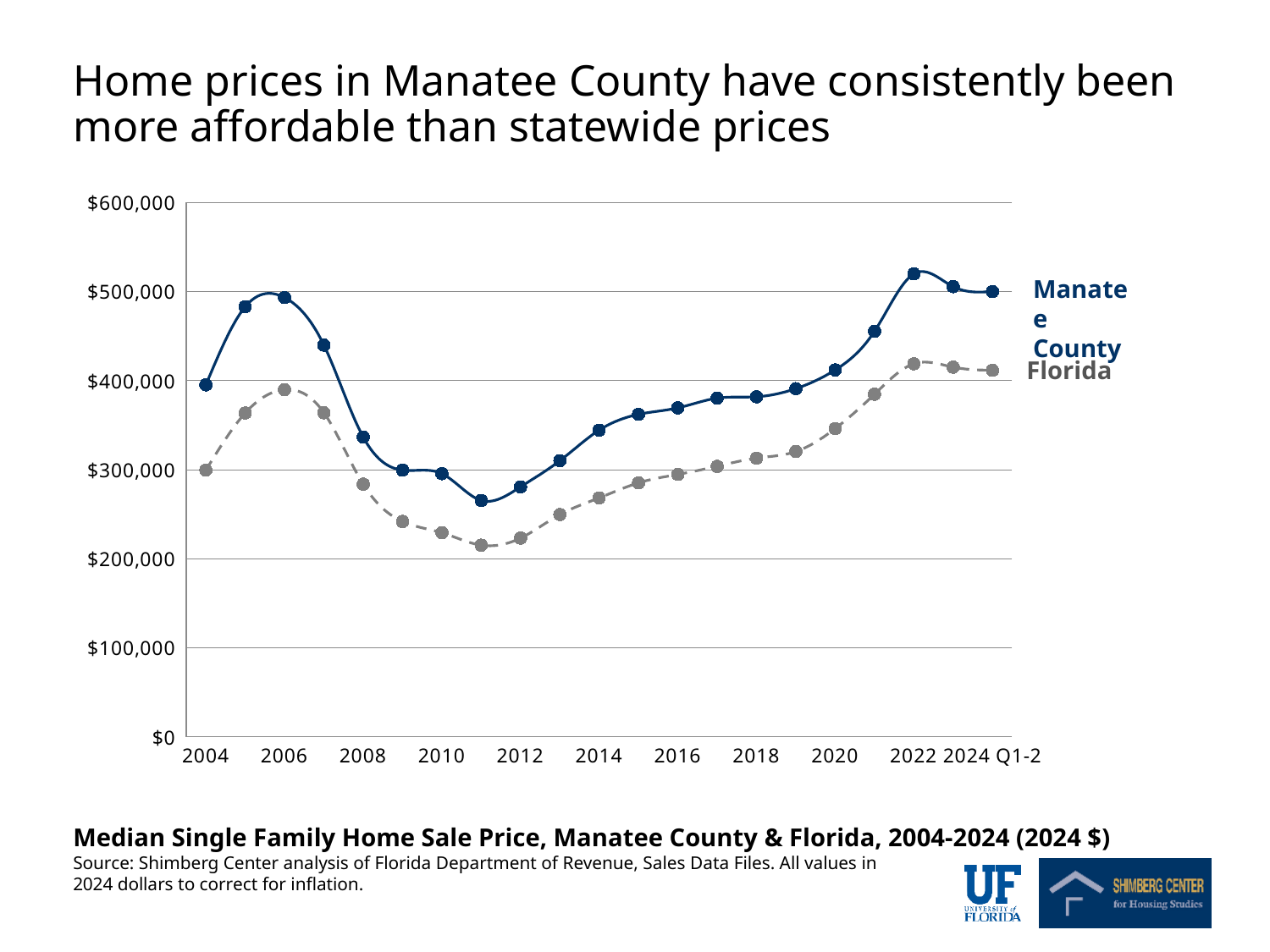
In which year does the Manatee County series reach its highest value? 2022 Is the Manatee County value for 2022 greater or less than $500,000? greater Does the Manatee County series rise or fall between 2011 and 2022? rise How many series does the chart show? 2 What kind of chart is shown on the slide? line chart In 2016, which series has the higher value, Manatee County or Florida? Manatee County Which two series are plotted on the chart? Manatee County and Florida In which year does the Florida series reach its lowest value? 2011 Is the Manatee County value for 2011 greater or less than $300,000? less Is the Florida value for 2022 greater or less than $400,000? greater What is the title of the chart? Median Single Family Home Sale Price, Manatee County & Florida, 2004-2024 (2024 $) In which year does the Manatee County series reach its lowest value? 2011